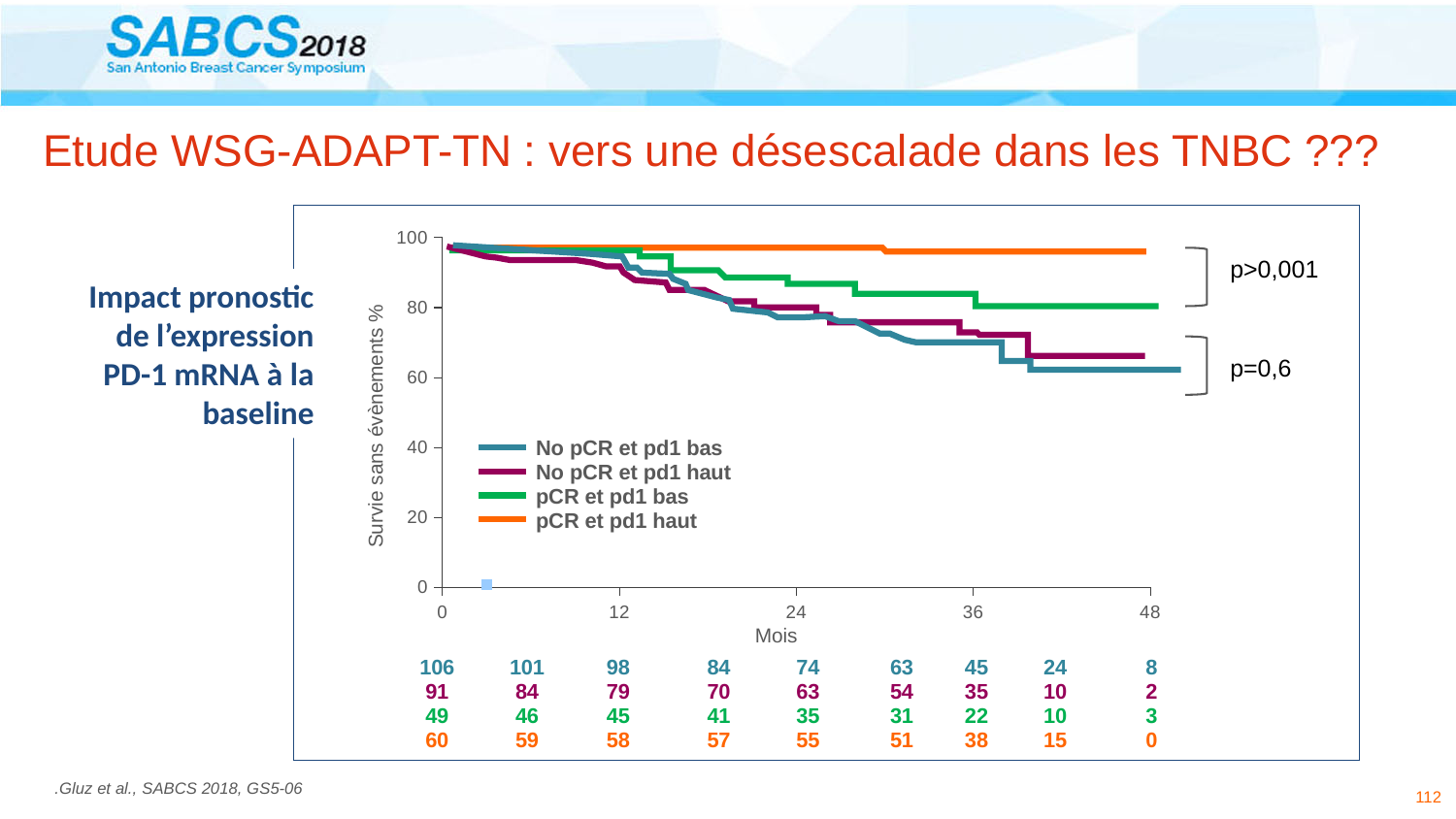
According to the numbers-at-risk table, how many patients were at risk at 48 months in the 'pCR et pd1 haut' group? 0 Is the event-free survival for 'pCR et pd1 haut' at 48 months greater or less than 80? greater At 24 months, which group has more patients at risk: 'pCR et pd1 bas' or 'pCR et pd1 haut'? pCR et pd1 haut What kind of chart is shown on the slide? line chart According to the numbers-at-risk table, how many patients were at risk at 0 months in the 'No pCR et pd1 bas' group? 106 Is the event-free survival for 'No pCR et pd1 bas' at 48 months greater or less than 80? less Do the survival curves rise or fall as months increase along the x axis? fall How many series does the legend list? 4 According to the numbers-at-risk table, how many patients were at risk at 36 months in the 'pCR et pd1 bas' group? 22 Which group has the highest event-free survival at 48 months? pCR et pd1 haut What is the label of the y axis? Survie sans évènements % What is the difference in the number of patients at risk at 0 months between the 'No pCR et pd1 bas' group and the 'No pCR et pd1 haut' group? 15